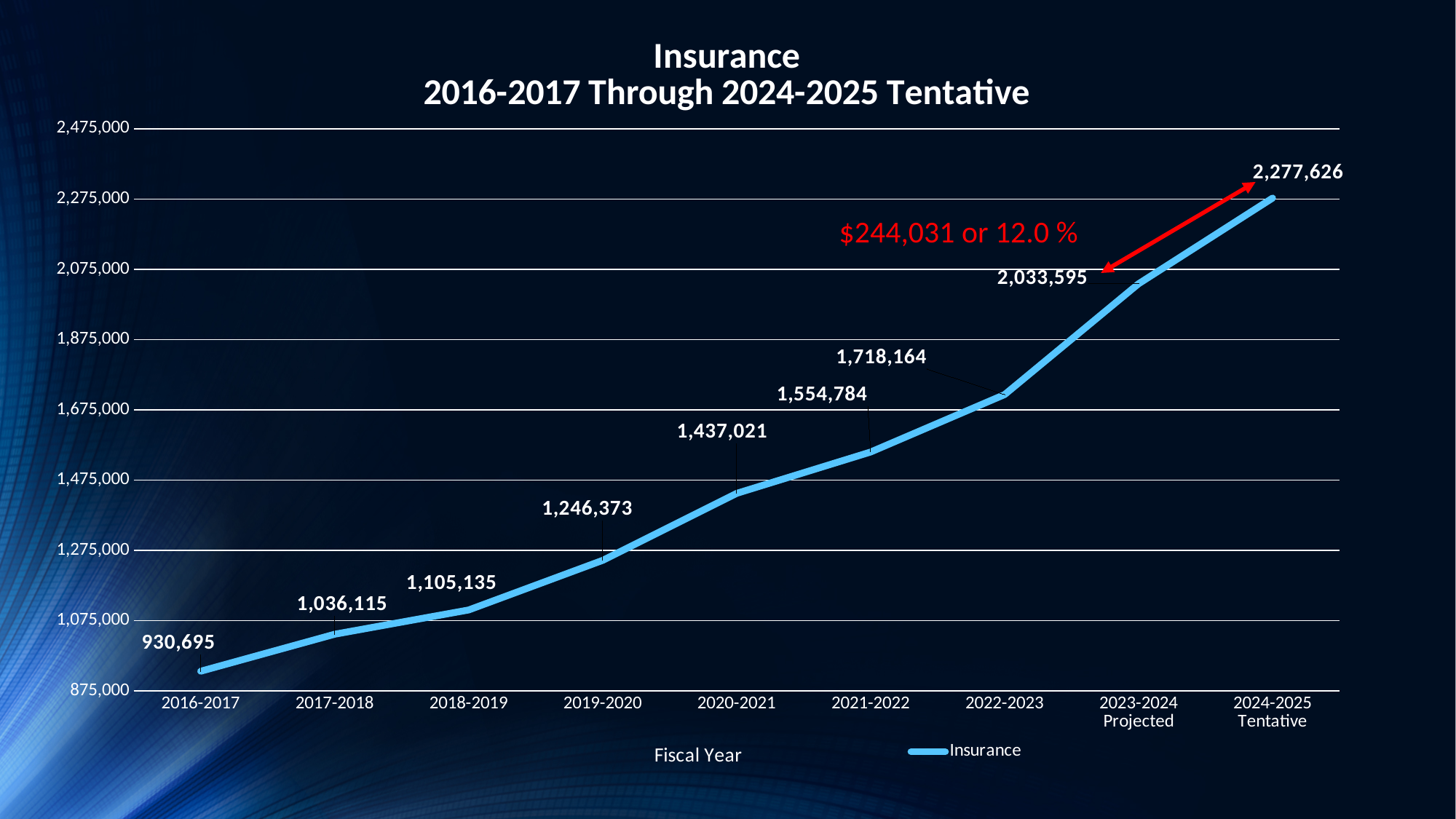
What is the Insurance value for 2016-2017? 930,695 What is the Insurance value for 2024-2025 Tentative? 2,277,626 What is the difference between the Insurance values for 2018-2019 and 2017-2018? 69,020 Do the Insurance values rise or fall from 2016-2017 to 2024-2025 Tentative? Rise Which is larger, the Insurance value for 2019-2020 or for 2021-2022? 2021-2022 What kind of chart is shown on the slide? Line chart What is the Insurance value for 2023-2024 Projected? 2,033,595 How many fiscal years are plotted on the chart? 9 Which fiscal year has the lowest Insurance value? 2016-2017 What is the difference between the Insurance values for 2024-2025 Tentative and 2023-2024 Projected? 244,031 What is the Insurance value for 2020-2021? 1,437,021 Which fiscal year has the highest Insurance value? 2024-2025 Tentative